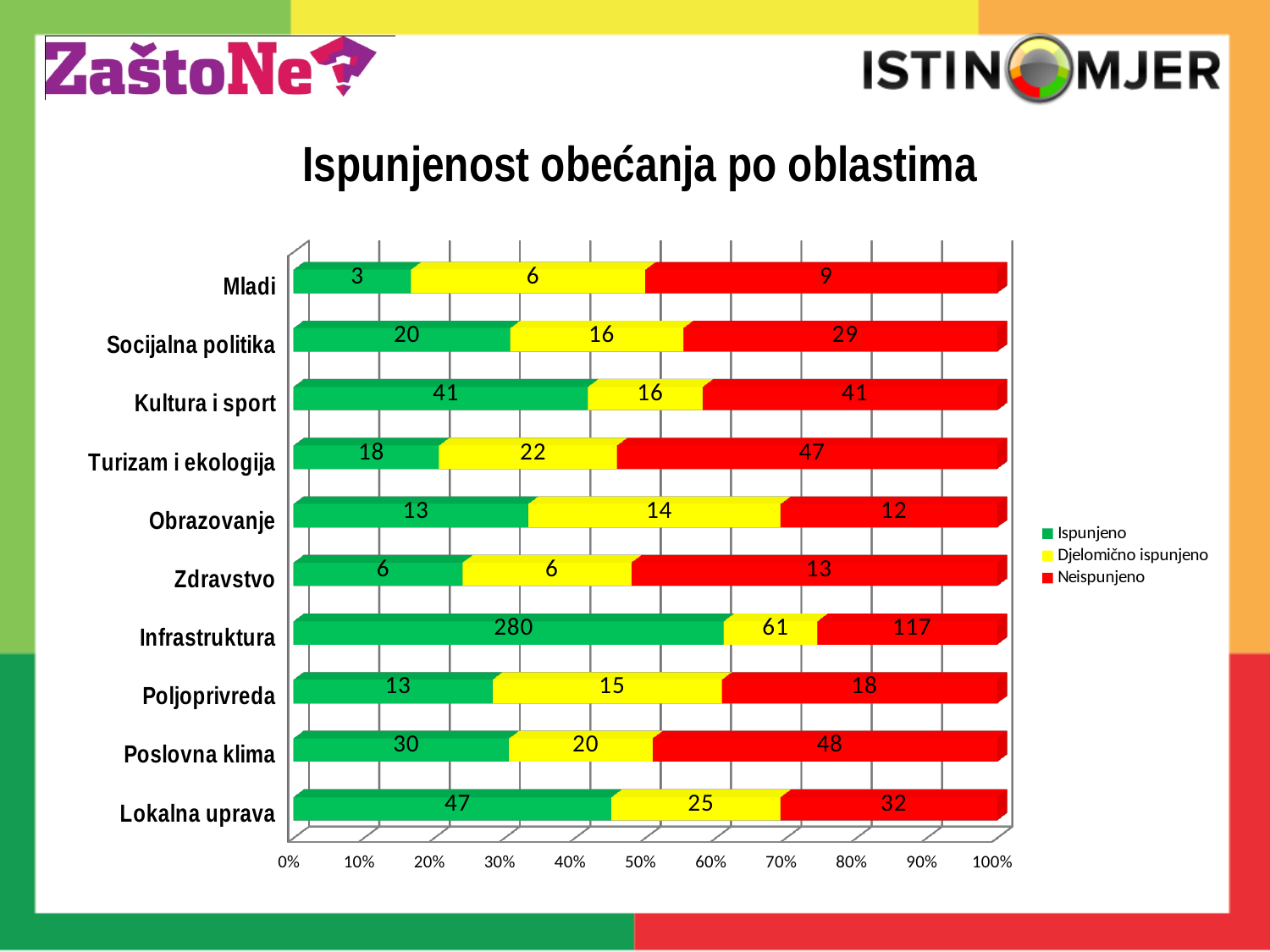
What is the total of the three values in the Infrastruktura bar? 458 What is the Ispunjeno value for Infrastruktura? 280 What kind of chart is shown on the slide? Stacked bar chart Which category has the lowest Neispunjeno value? Mladi What is the title of the chart? Ispunjenost obećanja po oblastima What is the Neispunjeno value for Turizam i ekologija? 47 What is the Djelomično ispunjeno value for Lokalna uprava? 25 What is the difference between the Neispunjeno and Ispunjeno values for Poslovna klima? 18 How many series does the legend list? 3 Which is larger for Obrazovanje: the Ispunjeno value or the Djelomično ispunjeno value? Djelomično ispunjeno Which category has the highest Ispunjeno value? Infrastruktura How many categories are shown on the chart? 10